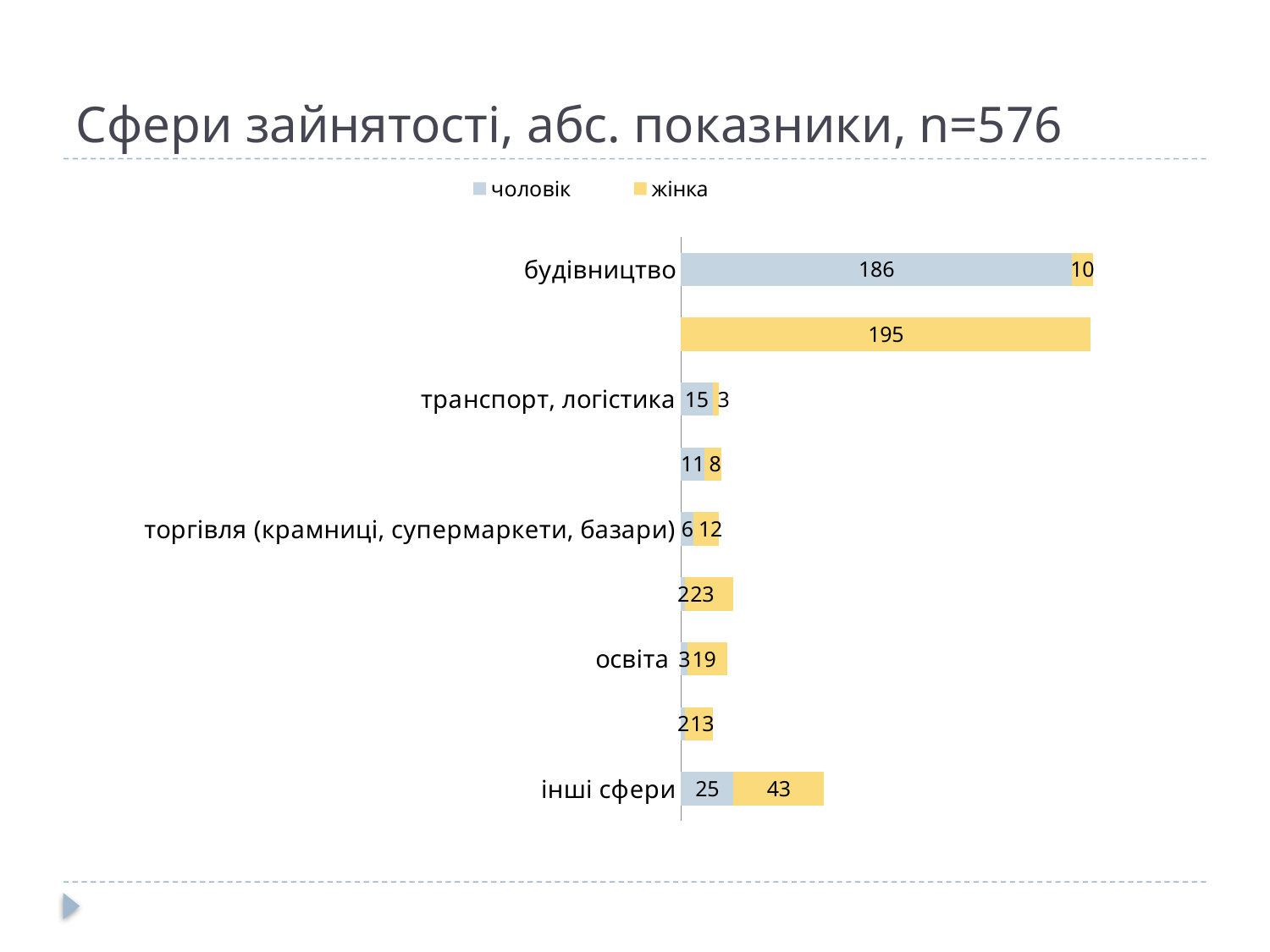
What is the value for чоловік in the будівництво category? 186 What is the total of the stacked bar for інші сфери? 68 What is the value for жінка in the інші сфери category? 43 Which category has the highest value for чоловік? будівництво In the інші сфери category, how much larger is the жінка value than the чоловік value? 18 In the торгівля (крамниці, супермаркети, базари) category, which series has the larger value, чоловік or жінка? жінка How many series does the legend list? 2 What is the total of the stacked bar for будівництво? 196 What is the value for жінка in the будівництво category? 10 What is the value for чоловік in the транспорт, логістика category? 15 What is the value for жінка in the освіта category? 19 What is the value for чоловік in the інші сфери category? 25